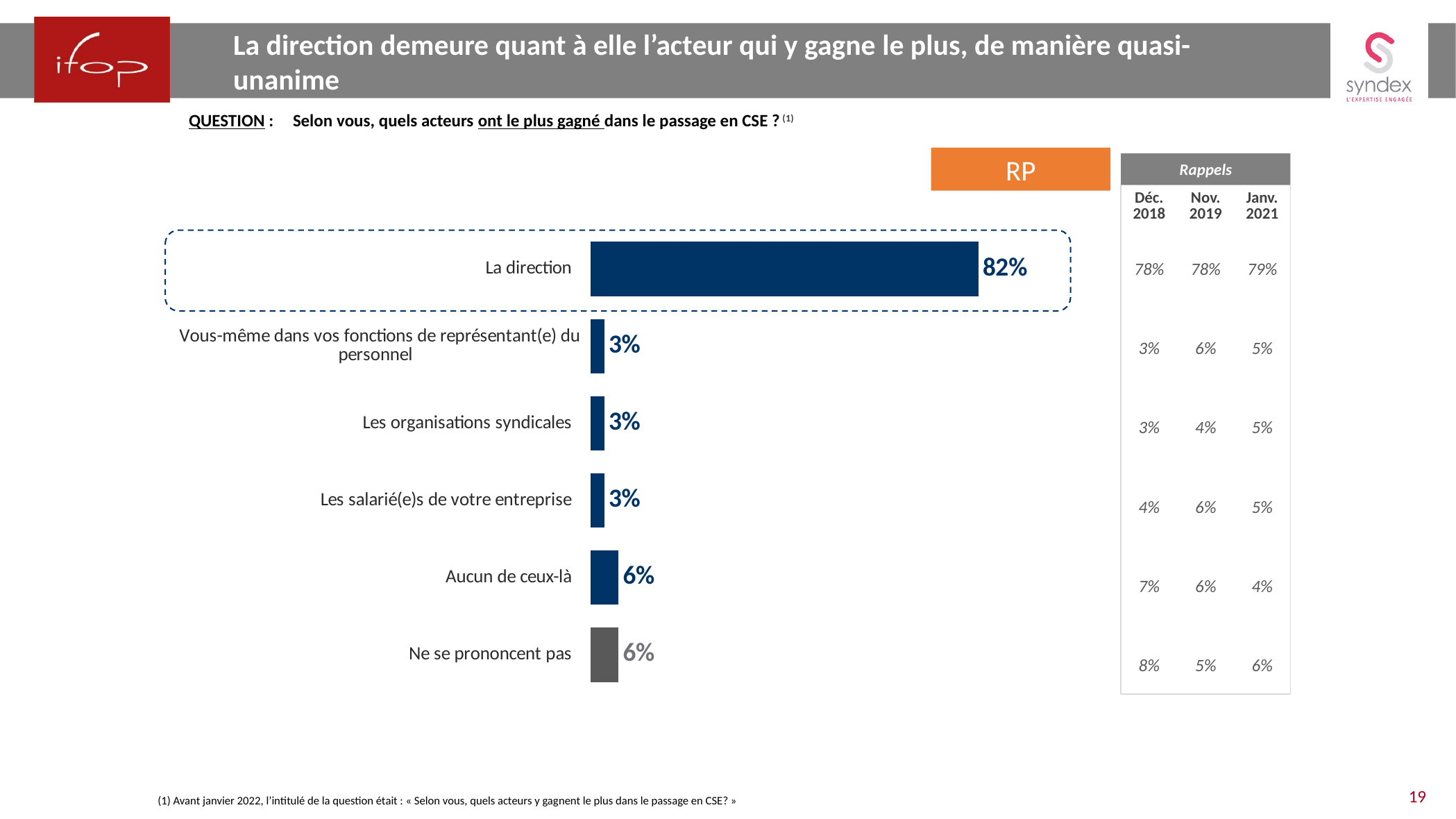
What is the value for Les organisations syndicales? 3% What kind of chart is shown on the slide? bar chart What is the difference between the value for La direction and the value for Aucun de ceux-là? 76% What label appears in the orange box above the bar chart? RP What is the value for La direction? 82% Which is larger: the value for Aucun de ceux-là or the value for Les salarié(e)s de votre entreprise? Aucun de ceux-là How many categories are shown in the bar chart? 6 What is the value for Aucun de ceux-là? 6% In the Rappels table, what was the value for Aucun de ceux-là in Déc. 2018? 7% What is the value for Ne se prononcent pas? 6% Which category has the highest value? La direction In the Rappels table, what was the value for La direction in Janv. 2021? 79%